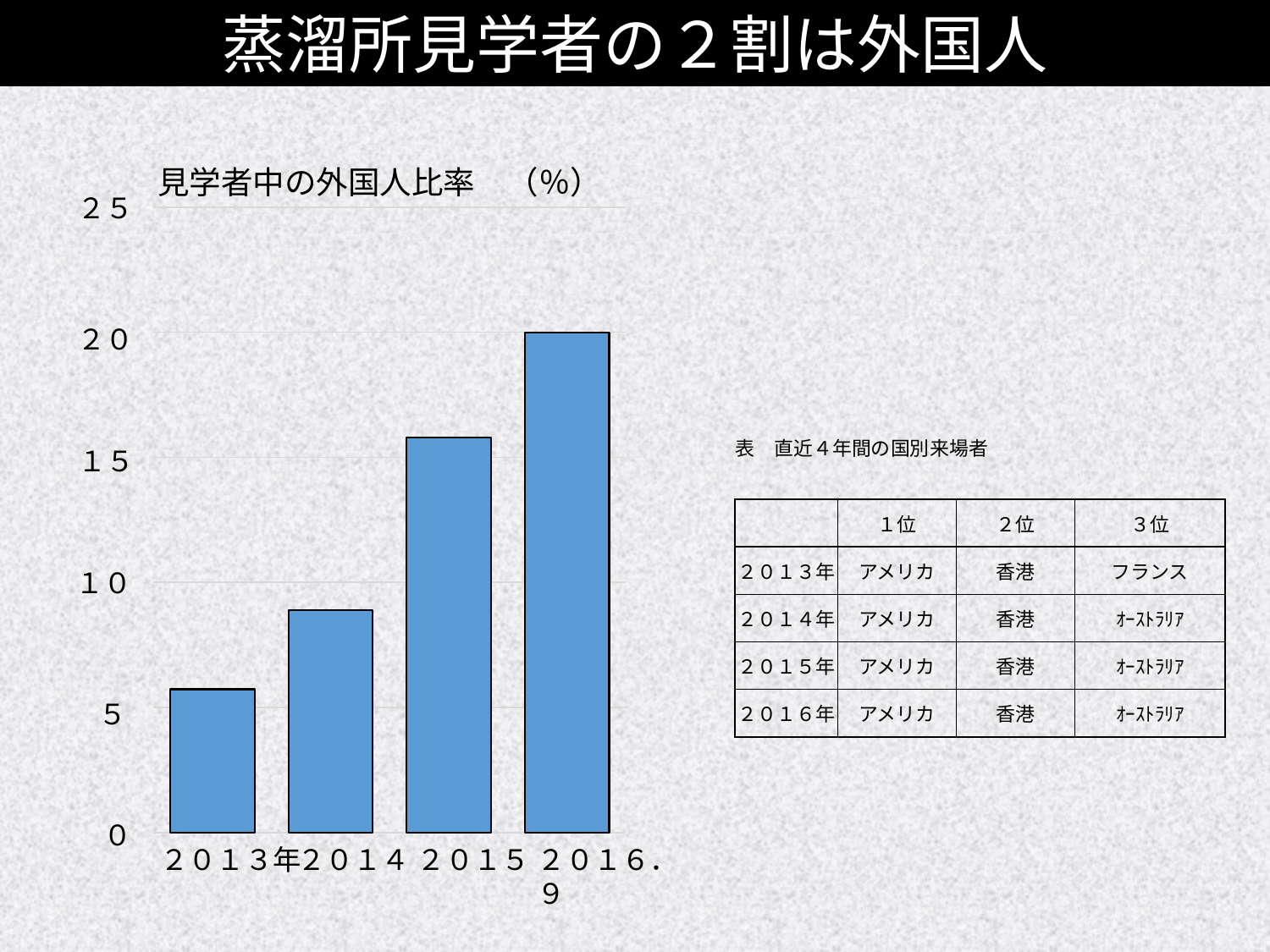
What kind of chart is shown on the slide? bar chart How many bars (categories) does the chart show? 4 Which category has the lowest value in the chart? 2013年 Is the value for 2013年 greater or less than 5? greater Is the value for 2014 greater or less than 10? less Do the values rise or fall from 2013年 to 2016.9? rise Is the value for 2015 greater or less than 15? greater Which is larger, the value for 2014 or the value for 2015? 2015 Which category has the highest value in the chart? 2016.9 What is the title of the chart? 見学者中の外国人比率 （%） What colour are the bars in the chart? blue